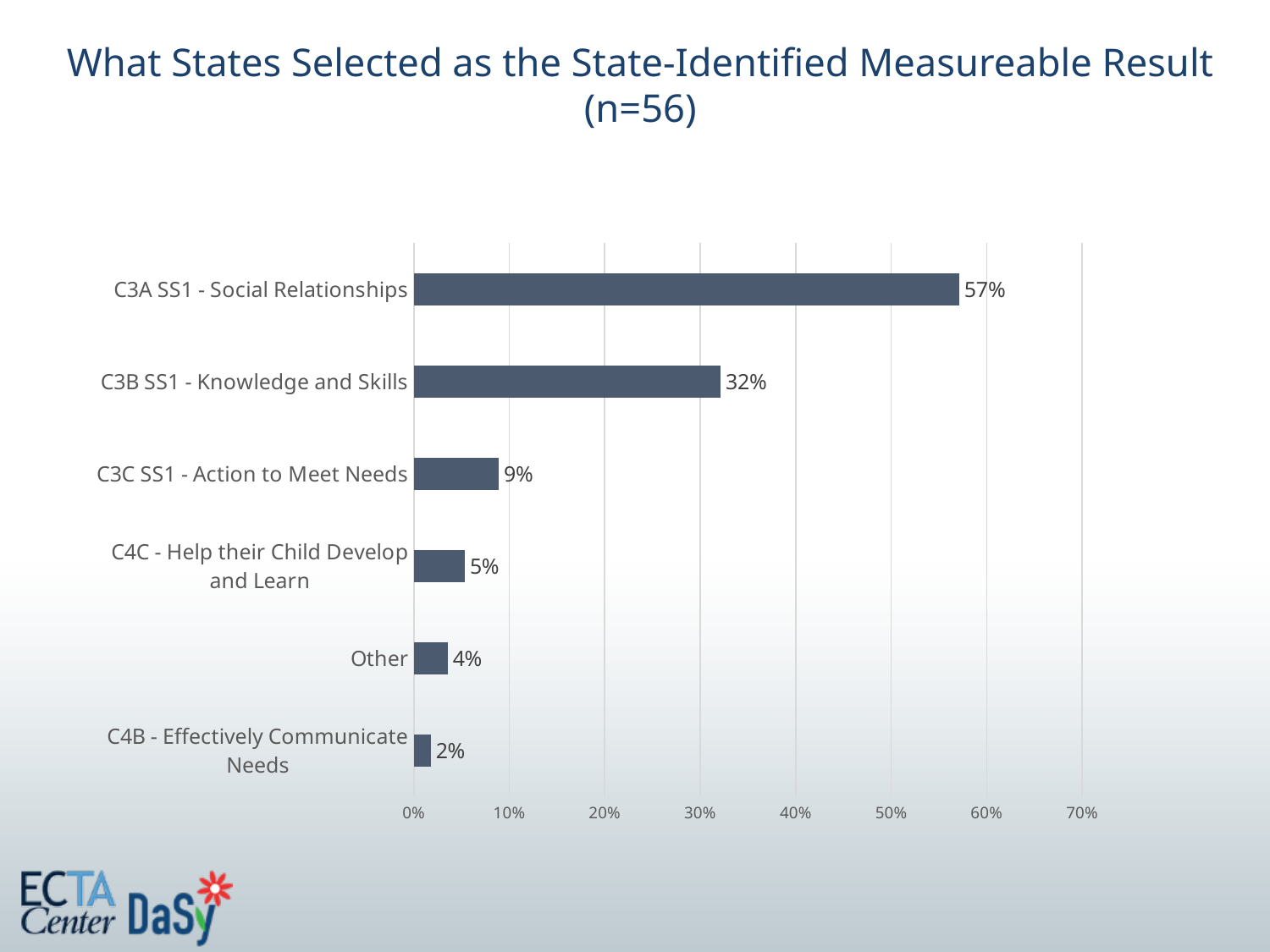
What is the difference between the values for C3C SS1 - Action to Meet Needs and C4B - Effectively Communicate Needs? 7% What is the value shown for the Other category? 4% Which category has the highest value? C3A SS1 - Social Relationships What is the value shown for C3B SS1 - Knowledge and Skills? 32% What is the sample size (n) given in the chart title? 56 How many categories are shown in the chart? 6 What is the value shown for C4C - Help their Child Develop and Learn? 5% Which is larger, the value for C3C SS1 - Action to Meet Needs or the value for Other? C3C SS1 - Action to Meet Needs What kind of chart is shown on the slide? Bar chart Which category has the lowest value? C4B - Effectively Communicate Needs What percentage of states selected C3A SS1 - Social Relationships as the State-Identified Measureable Result? 57% What is the difference between the values for C3A SS1 - Social Relationships and C3B SS1 - Knowledge and Skills? 25%